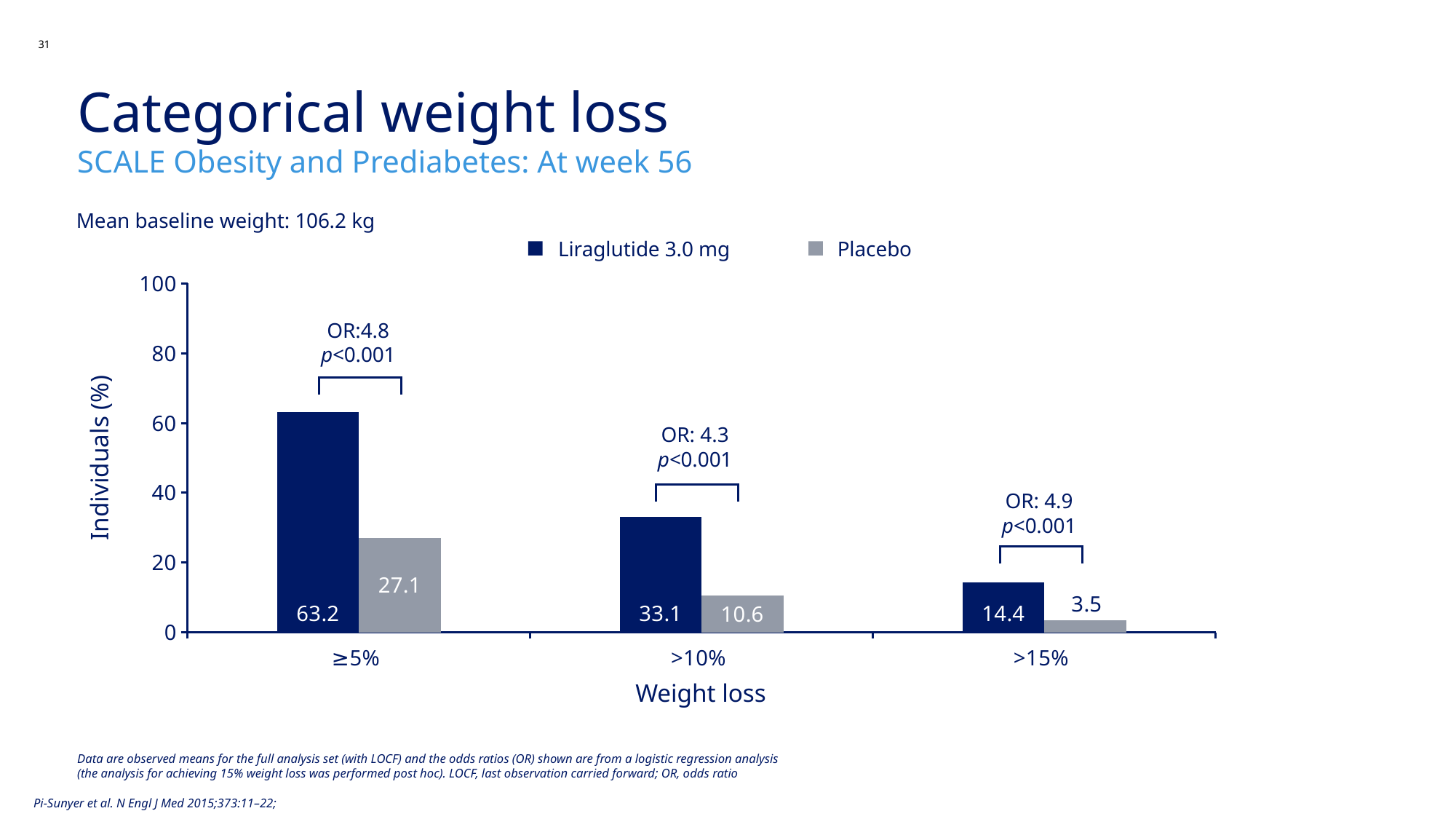
What percentage of individuals on Liraglutide 3.0 mg achieved ≥5% weight loss? 63.2 What percentage of individuals on Placebo achieved >10% weight loss? 10.6 What is the difference between the Liraglutide 3.0 mg and Placebo values in the >15% category? 10.9 What is the value for Placebo in the >15% weight loss category? 3.5 In which weight loss category is the Liraglutide 3.0 mg value highest? ≥5% What kind of chart is shown on the slide? Bar chart What is the odds ratio shown above the >15% weight loss category? 4.9 In which weight loss category is the Placebo value lowest? >15% How many series does the legend list? 2 What is the difference between the Liraglutide 3.0 mg and Placebo values in the ≥5% category? 36.1 Which is larger in the >10% category: Liraglutide 3.0 mg or Placebo? Liraglutide 3.0 mg How many weight loss categories are shown on the x axis? 3